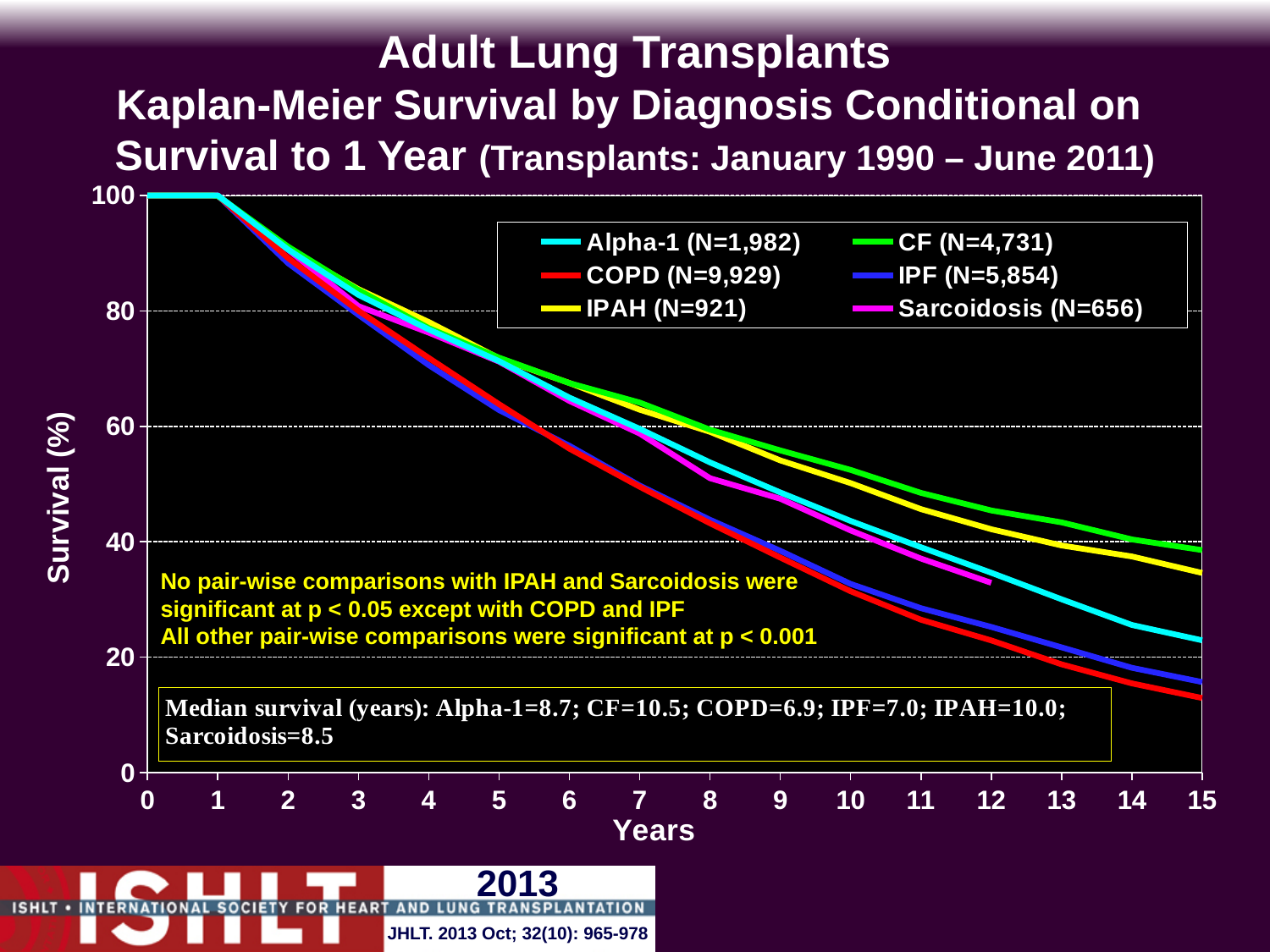
Which curve is highest at 15 years? CF Do the survival curves rise or fall as years increase? Fall Is the survival value for CF at 15 years greater or less than 40? less What is the median survival in years for CF according to the text box? 10.5 Which diagnosis group has the largest N in the legend? COPD (N=9,929) Which diagnosis group has the highest median survival listed in the text box? CF What is the difference in median survival (years) between CF and COPD? 3.6 Which diagnosis group has the lowest median survival listed in the text box? COPD Is the survival value for COPD at 15 years greater or less than 20? less What kind of chart is shown on the slide? Line chart What is the median survival in years for COPD according to the text box? 6.9 How many diagnosis groups does the legend list? 6